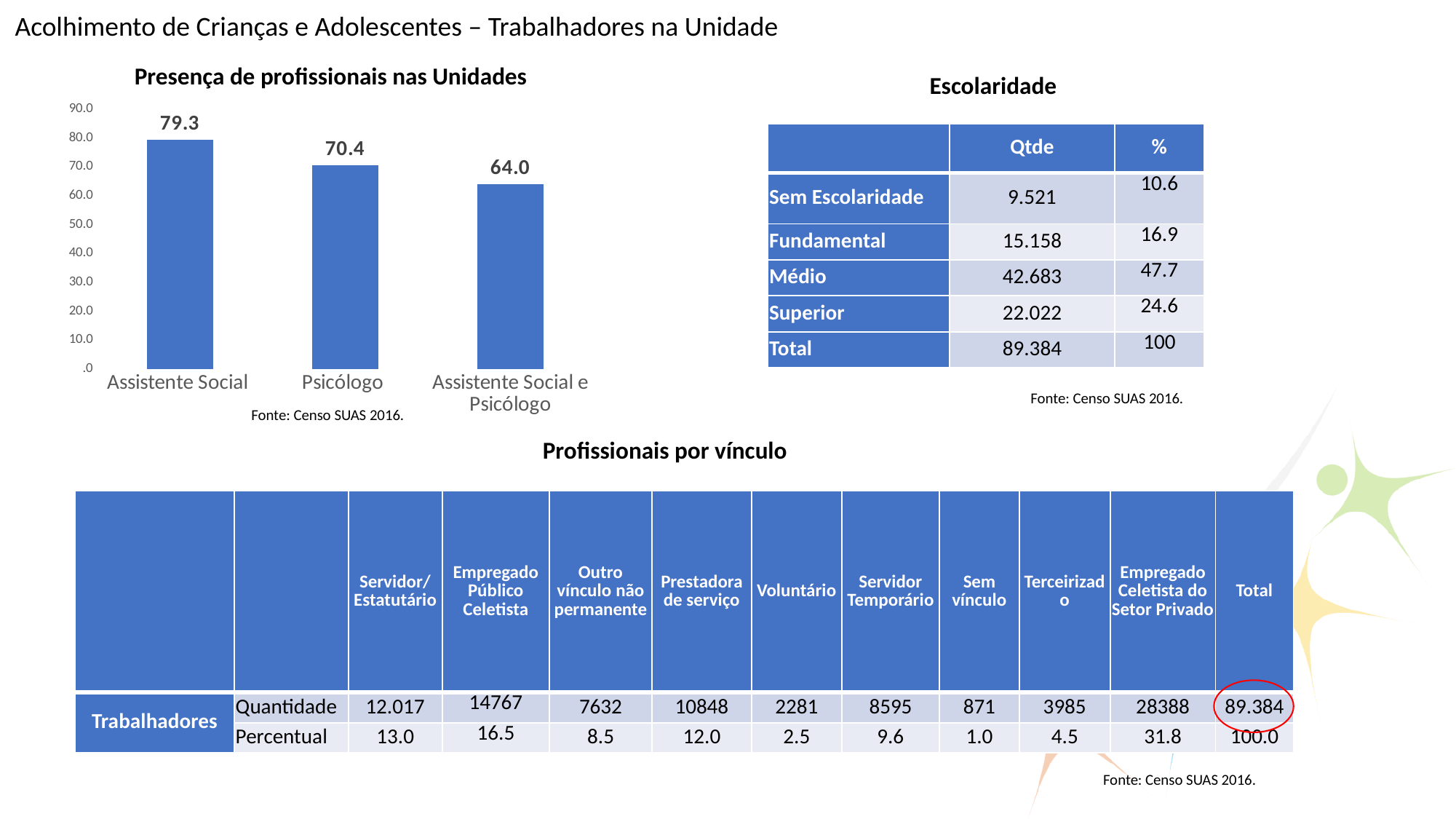
In the chart 'Presença de profissionais nas Unidades', what is the value for Assistente Social? 79.3 In the chart 'Presença de profissionais nas Unidades', what is the value for Psicólogo? 70.4 What kind of chart is 'Presença de profissionais nas Unidades'? bar chart In the chart 'Presença de profissionais nas Unidades', is the value for Assistente Social e Psicólogo greater or less than 70.0? less In the chart 'Presença de profissionais nas Unidades', what is the difference between the values for Psicólogo and Assistente Social e Psicólogo? 6.4 In the chart 'Presença de profissionais nas Unidades', which category has the lowest value? Assistente Social e Psicólogo In the chart 'Presença de profissionais nas Unidades', which category has the highest value? Assistente Social In the chart 'Presença de profissionais nas Unidades', which is larger: the value for Psicólogo or for Assistente Social e Psicólogo? Psicólogo How many categories are shown in the chart 'Presença de profissionais nas Unidades'? 3 In the chart 'Presença de profissionais nas Unidades', what is the value for Assistente Social e Psicólogo? 64.0 In the chart 'Presença de profissionais nas Unidades', do the values rise or fall from left to right? fall In the chart 'Presença de profissionais nas Unidades', what is the difference between the values for Assistente Social and Psicólogo? 8.9